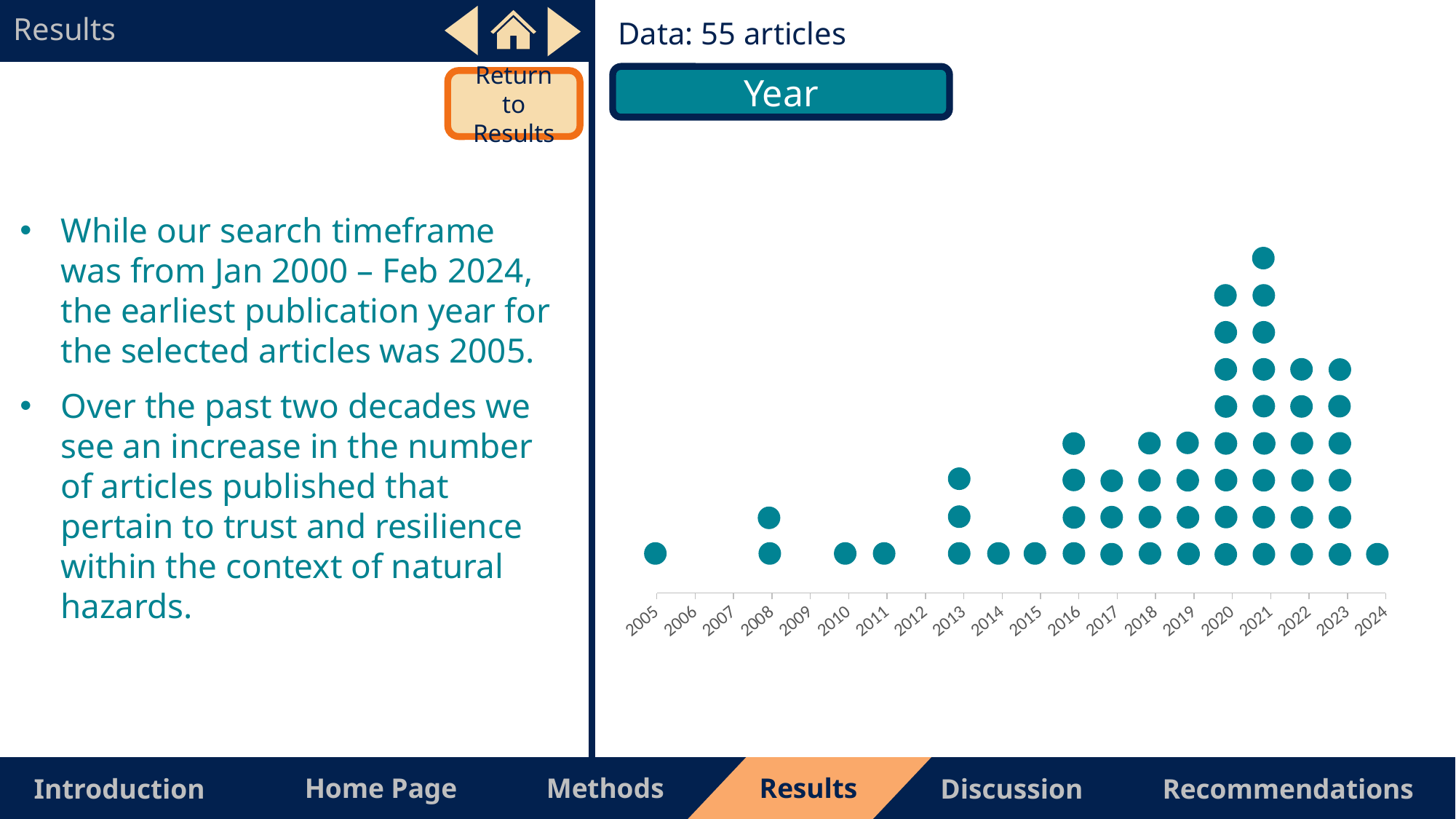
According to the text above the chart, how many articles make up the data? 55 articles How many year labels are shown along the x axis? 20 Which year has more dots, 2020 or 2022? 2020 How many dots are shown for 2008? 2 Do the number of articles generally rise or fall from 2005 to 2021? Rise Which year has the most dots (articles) in the chart? 2021 How many dots are shown for 2021? 9 How many dots are shown for 2020? 8 Which years on the x axis have no dots at all? 2006, 2007, 2009, 2012 What is the difference in the number of dots between 2021 and 2005? 8 How many dots are shown for 2013? 3 What kind of chart is shown on the slide? Dot plot